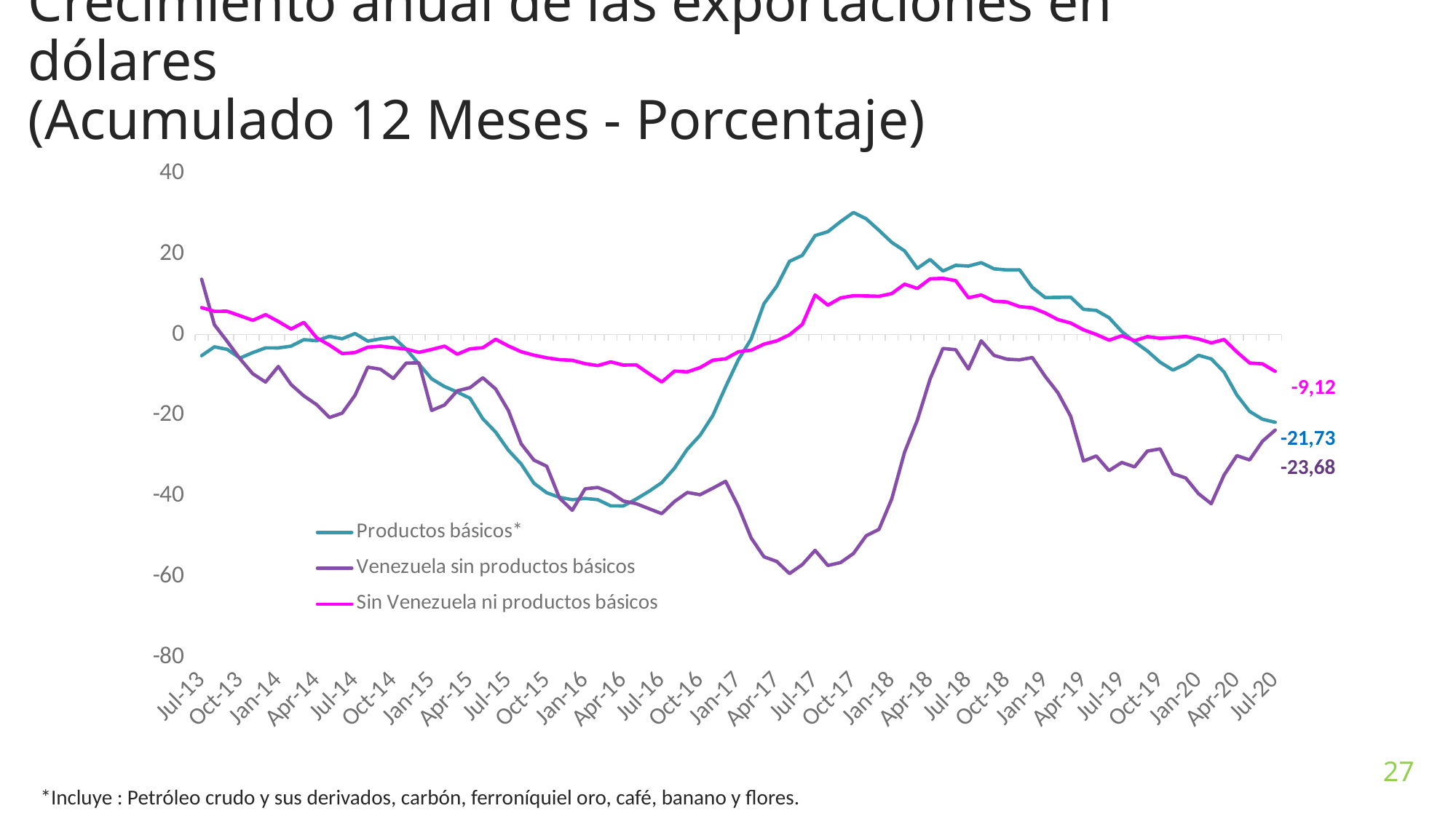
What is the value of the Sin Venezuela ni productos básicos series at Jul-20? -9,12 Is the value of the Productos básicos series at Oct-17 greater or less than 20? greater What is the value of the Productos básicos series at Jul-20? -21,73 Is the value of the Venezuela sin productos básicos series at Jul-17 greater or less than -40? less Which series has the lowest value at Jul-20? Venezuela sin productos básicos What colour is the line for the Sin Venezuela ni productos básicos series? magenta Which series has the highest value at Jul-20? Sin Venezuela ni productos básicos Does the Productos básicos series rise or fall between Jan-17 and Oct-17? rise What kind of chart is shown on the slide? line chart What is the difference between the Sin Venezuela ni productos básicos value and the Productos básicos value at Jul-20? 12,61 What is the value of the Venezuela sin productos básicos series at Jul-20? -23,68 How many series does the legend list? 3